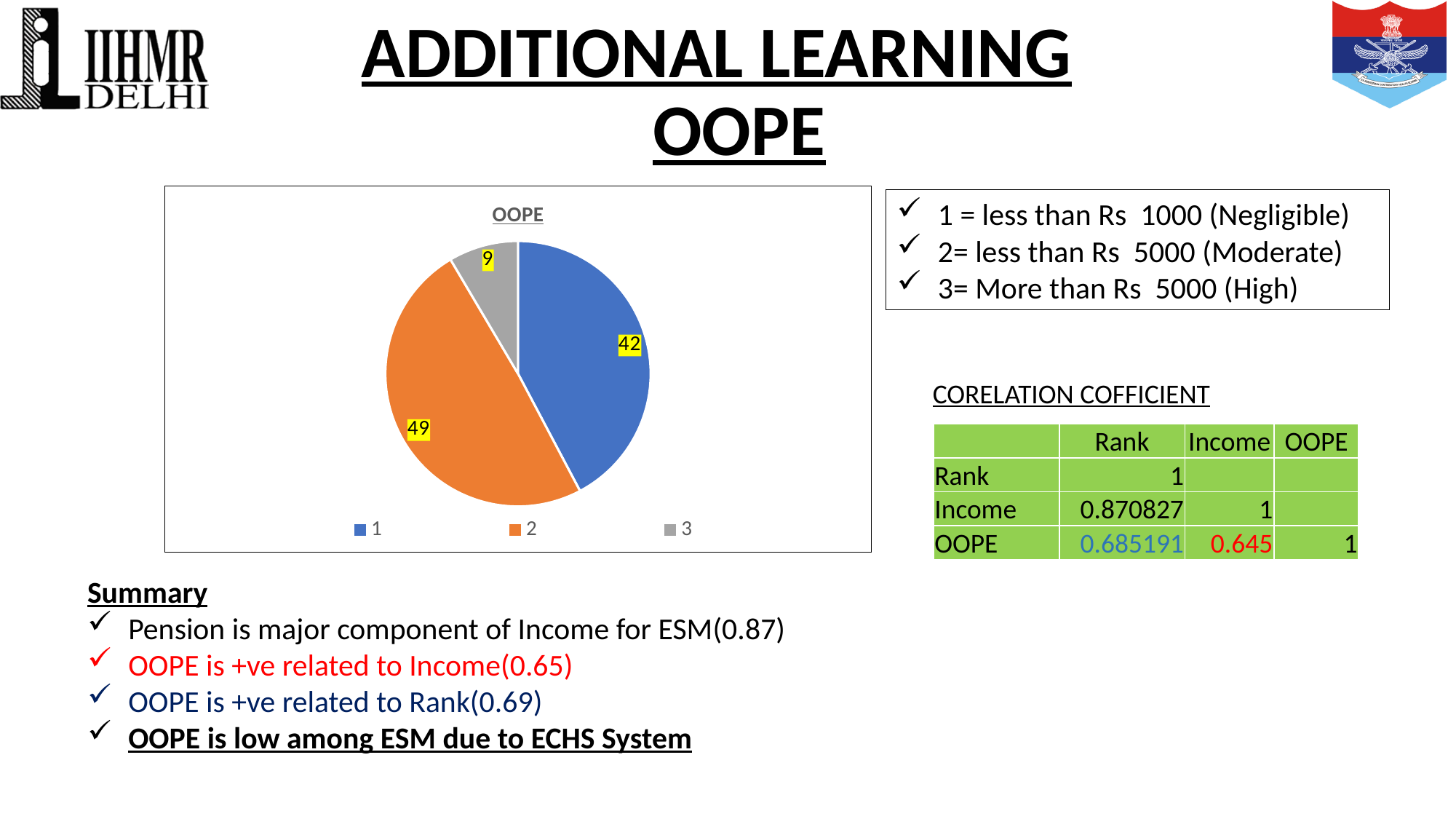
What is the difference between the values for category 2 and category 1 in the OOPE pie chart? 7 Which is larger in the OOPE pie chart, the value for category 1 or category 3? 1 What share of the OOPE pie chart does category 3 represent? 9% What is the value for category 2 in the OOPE pie chart? 49 How many slices does the OOPE pie chart have? 3 What type of chart is shown on the slide? pie chart What is the value for category 1 in the OOPE pie chart? 42 What colour is the slice for category 2 in the OOPE pie chart? orange What is the title of the chart? OOPE What is the value for category 3 in the OOPE pie chart? 9 Which category has the largest slice in the OOPE pie chart? 2 Which category has the smallest slice in the OOPE pie chart? 3